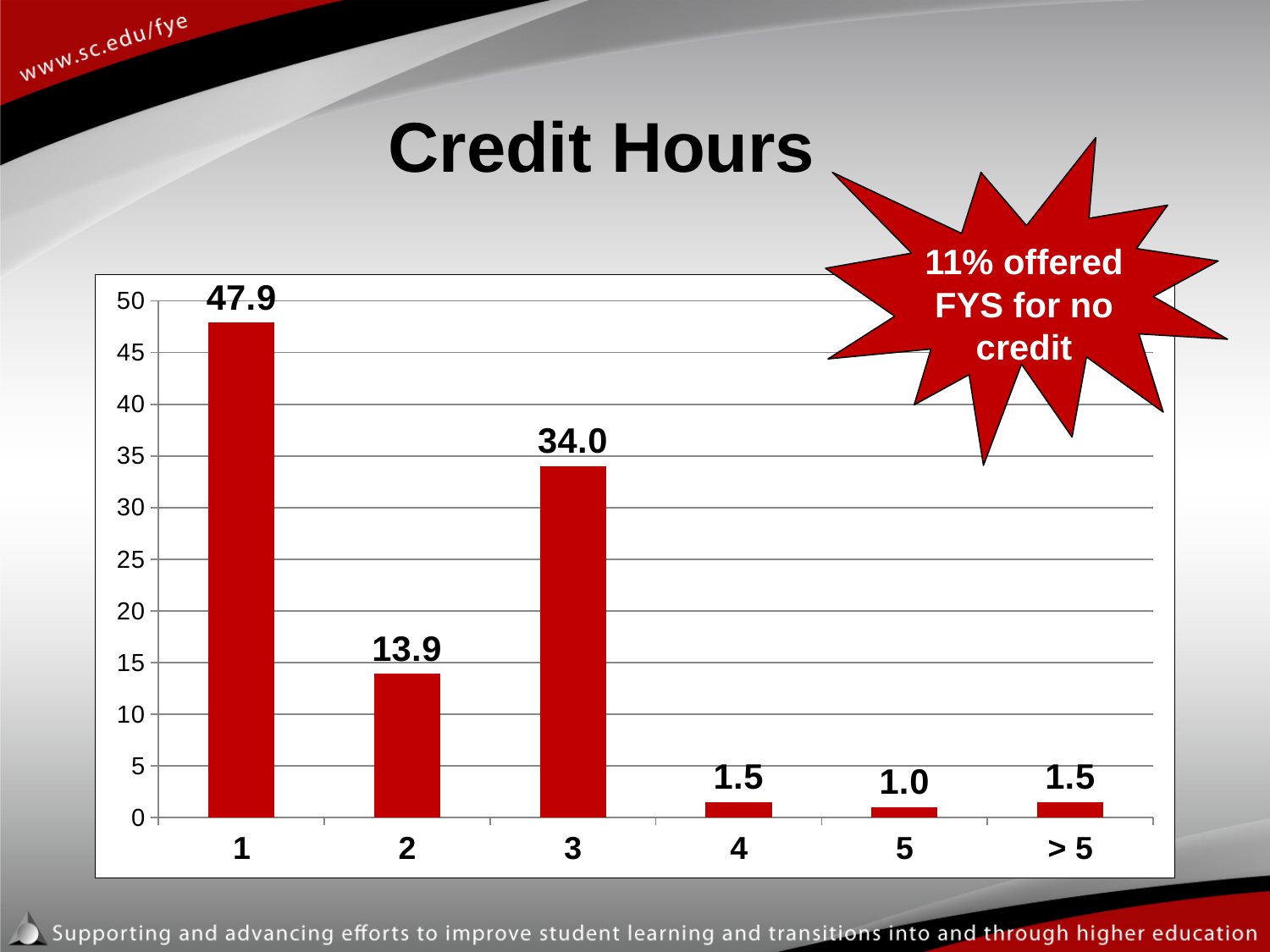
What is the value for the category 3 in the Credit Hours chart? 34.0 What is the value for the category 5 in the Credit Hours chart? 1.0 What is the title of the chart on the slide? Credit Hours What is the value for the category 1 in the Credit Hours chart? 47.9 What is the difference between the values for categories 3 and 2 in the Credit Hours chart? 20.1 What kind of chart is shown on the slide? Bar chart What is the difference between the values for categories 1 and 3 in the Credit Hours chart? 13.9 Which is larger in the Credit Hours chart, the value for category 2 or the value for category 3? 3 How many categories are shown on the x axis of the Credit Hours chart? 6 Which category has the highest value in the Credit Hours chart? 1 What is the value for the category 2 in the Credit Hours chart? 13.9 Which category has the lowest value in the Credit Hours chart? 5